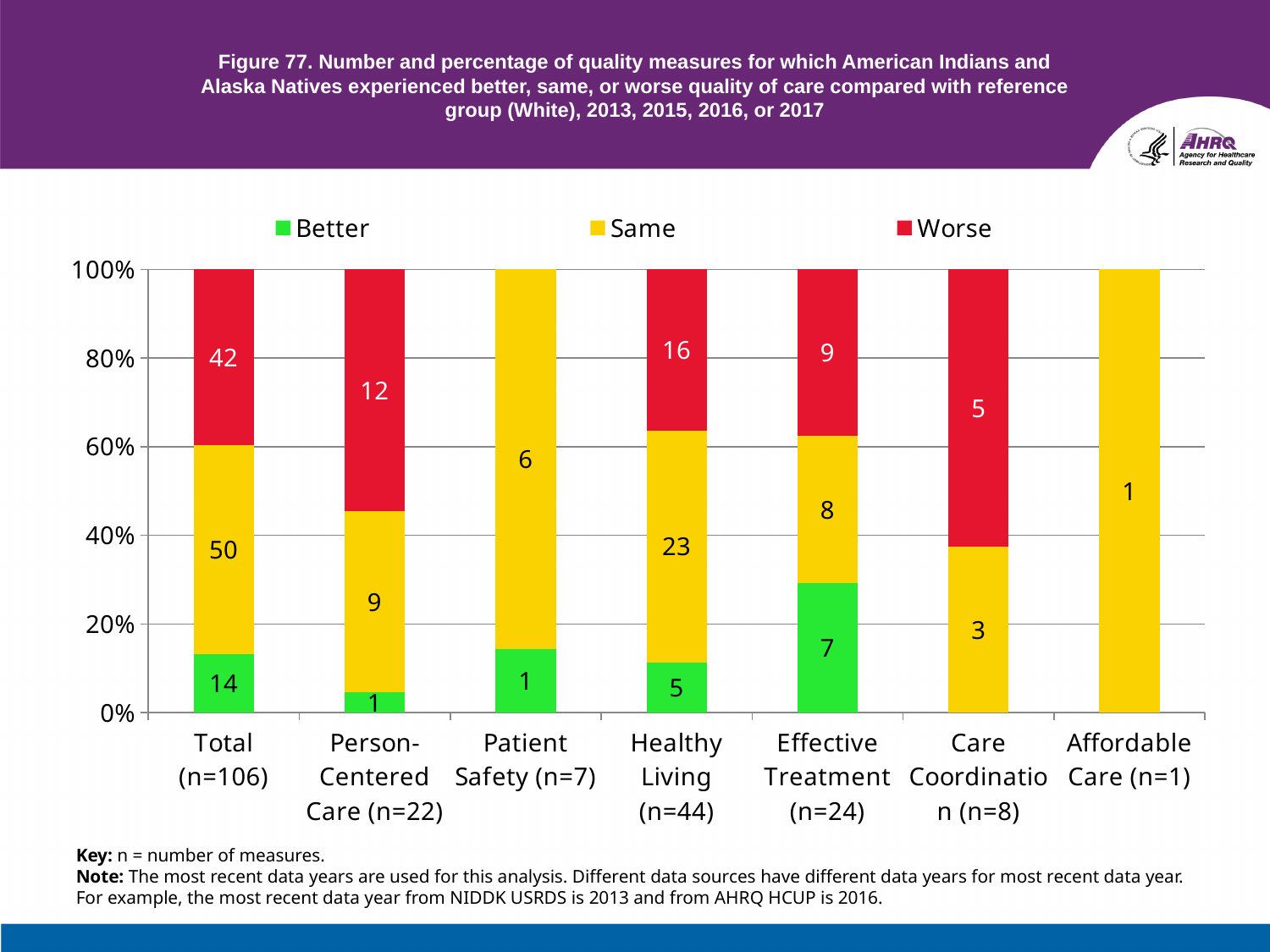
Which category has the highest number of Same measures? Total (n=106) What is the total number of measures in the Healthy Living bar (Better + Same + Worse)? 44 How many series does the legend list? 3 Excluding Total, which category has the lowest number of Worse measures among those with a Worse segment? Care Coordination (n=8) Which is larger for Person-Centered Care, the Worse count or the Same count? Worse What is the number of Same measures for Person-Centered Care? 9 What is the number of Better measures for Effective Treatment? 7 What is the number of Worse measures for Healthy Living? 16 How many categories are shown along the x axis? 7 Is the Better segment for Effective Treatment greater or less than 20% of its bar? greater What is the difference between the Same and Worse counts for the Total bar? 8 What kind of chart is shown on the slide? Stacked bar chart